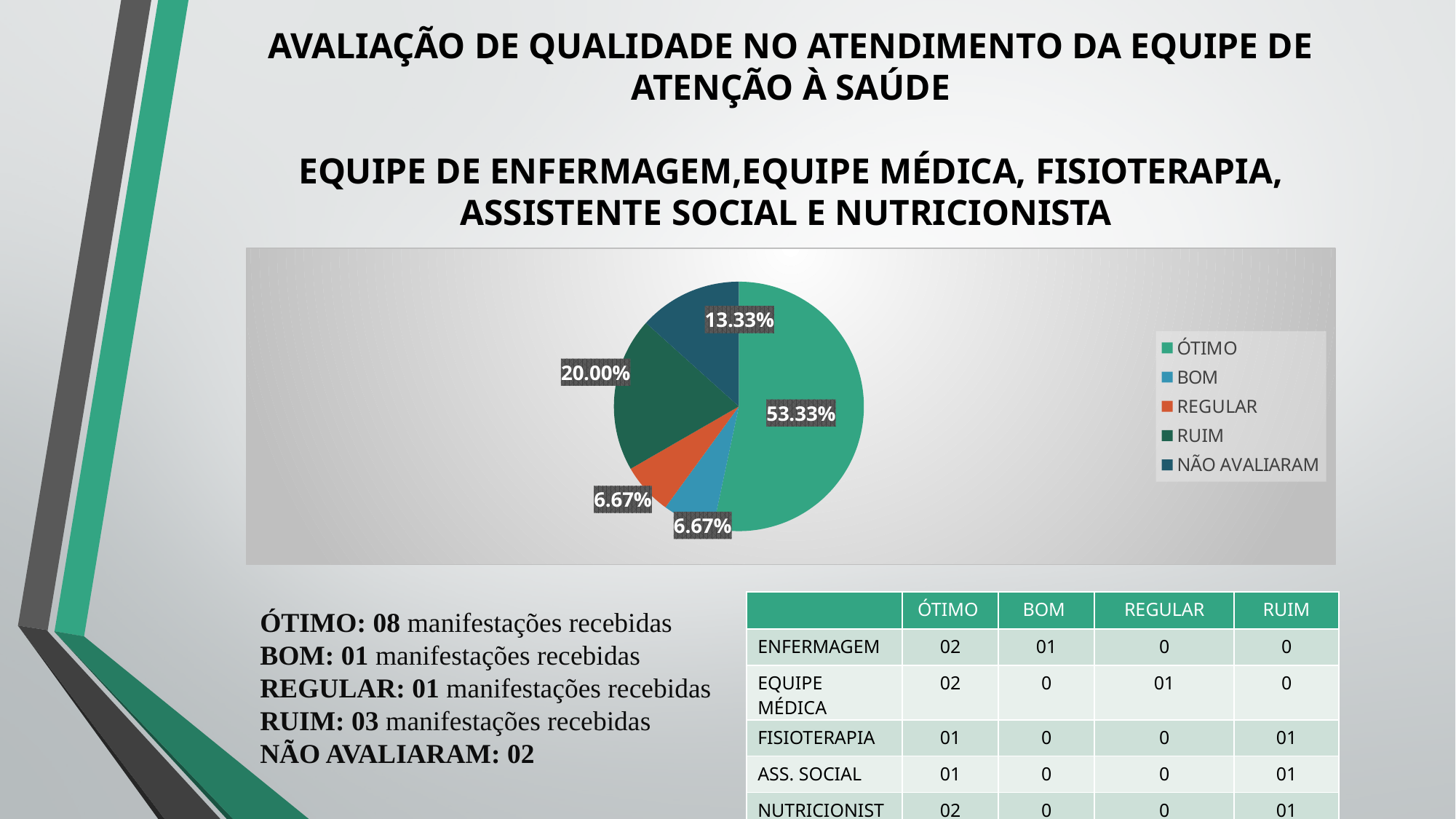
What share of the pie does NÃO AVALIARAM represent? 13.33% What share of the pie does BOM represent? 6.67% What colour is the ÓTIMO slice in the pie chart? green What kind of chart is shown on the slide? pie chart What share of the pie does ÓTIMO represent? 53.33% How many slices does the pie chart have? 5 What share of the pie does REGULAR represent? 6.67% Which category has the largest slice of the pie? ÓTIMO How many entries does the legend of the pie chart list? 5 Which slice is larger, RUIM or NÃO AVALIARAM? RUIM What is the difference in percentage points between the ÓTIMO slice and the RUIM slice? 33.33% What share of the pie does RUIM represent? 20.00%